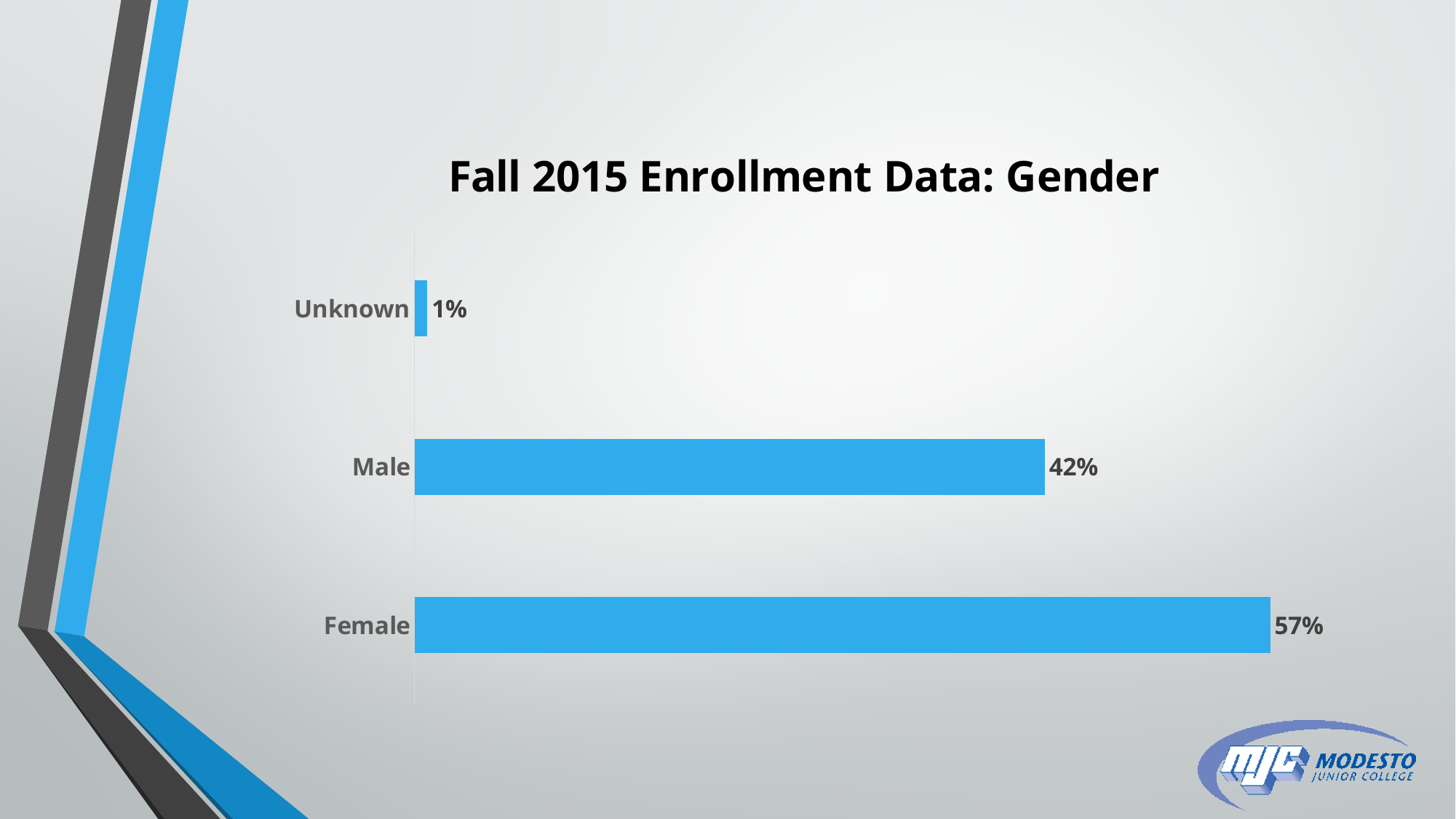
What is the value for Unknown? 1% Which category has the lowest value? Unknown What kind of chart is shown on the slide? Bar chart What colour are the bars in the chart? Blue What is the difference between the Male and Unknown values? 41% What is the value for Female? 57% Which is larger, the value for Male or the value for Female? Female What is the difference between the Female and Male values? 15% Which category has the highest value? Female How many categories are shown in the chart? 3 What is the value for Male? 42% What is the title of the chart? Fall 2015 Enrollment Data: Gender